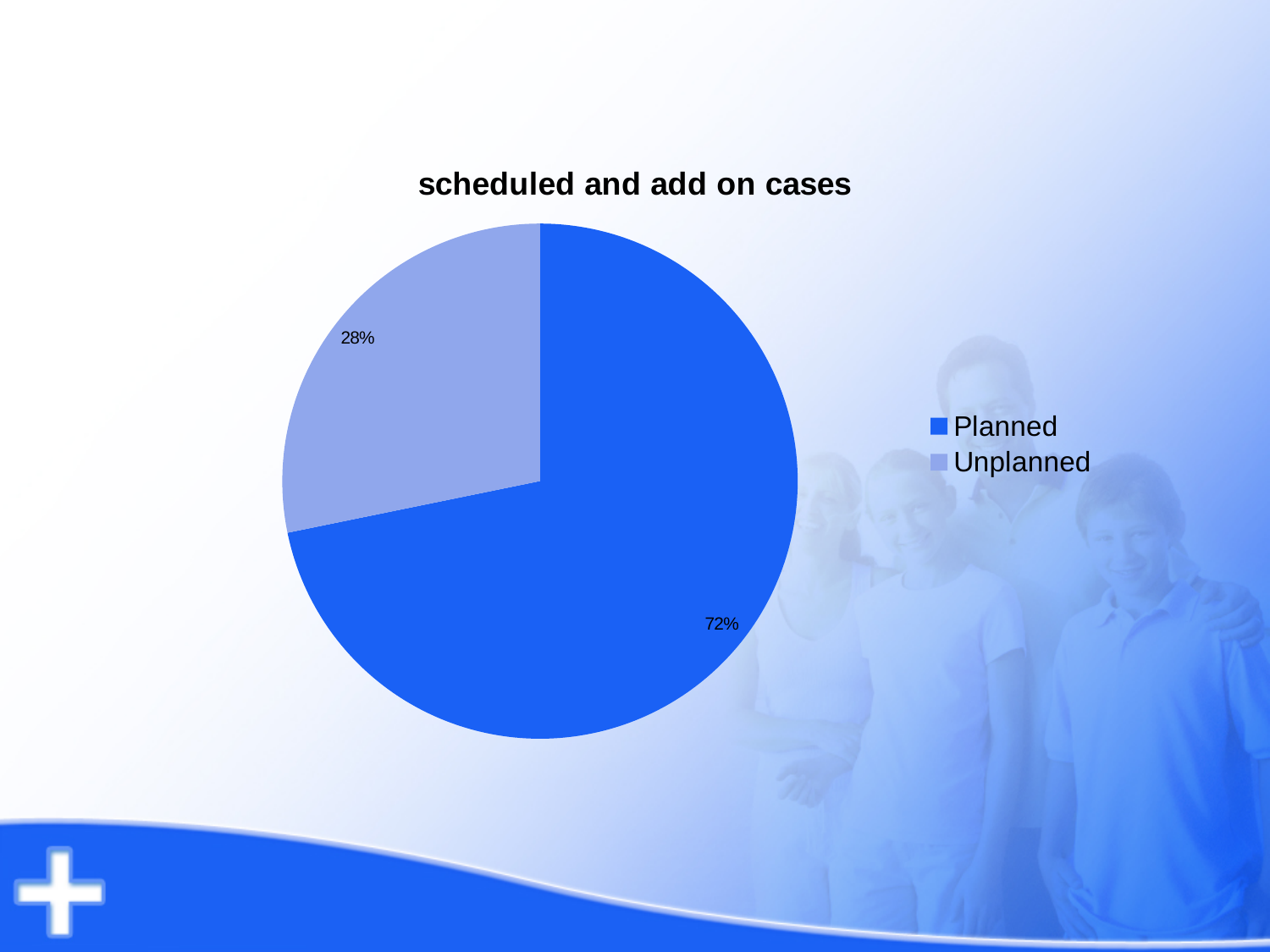
Which category has the largest slice of the pie? Planned What share of the pie does Unplanned represent? 28% Which is larger, the Planned slice or the Unplanned slice? Planned What share of the pie does Planned represent? 72% What is the title of the chart? scheduled and add on cases How many slices does the pie chart have? 2 What is the difference in percentage points between the Planned and Unplanned slices? 44 Which category has the smallest slice of the pie? Unplanned How many entries does the legend list? 2 Is the Unplanned slice greater or less than half of the pie? less What kind of chart is shown on the slide? Pie chart Which legend entry is shown in the lighter blue colour? Unplanned